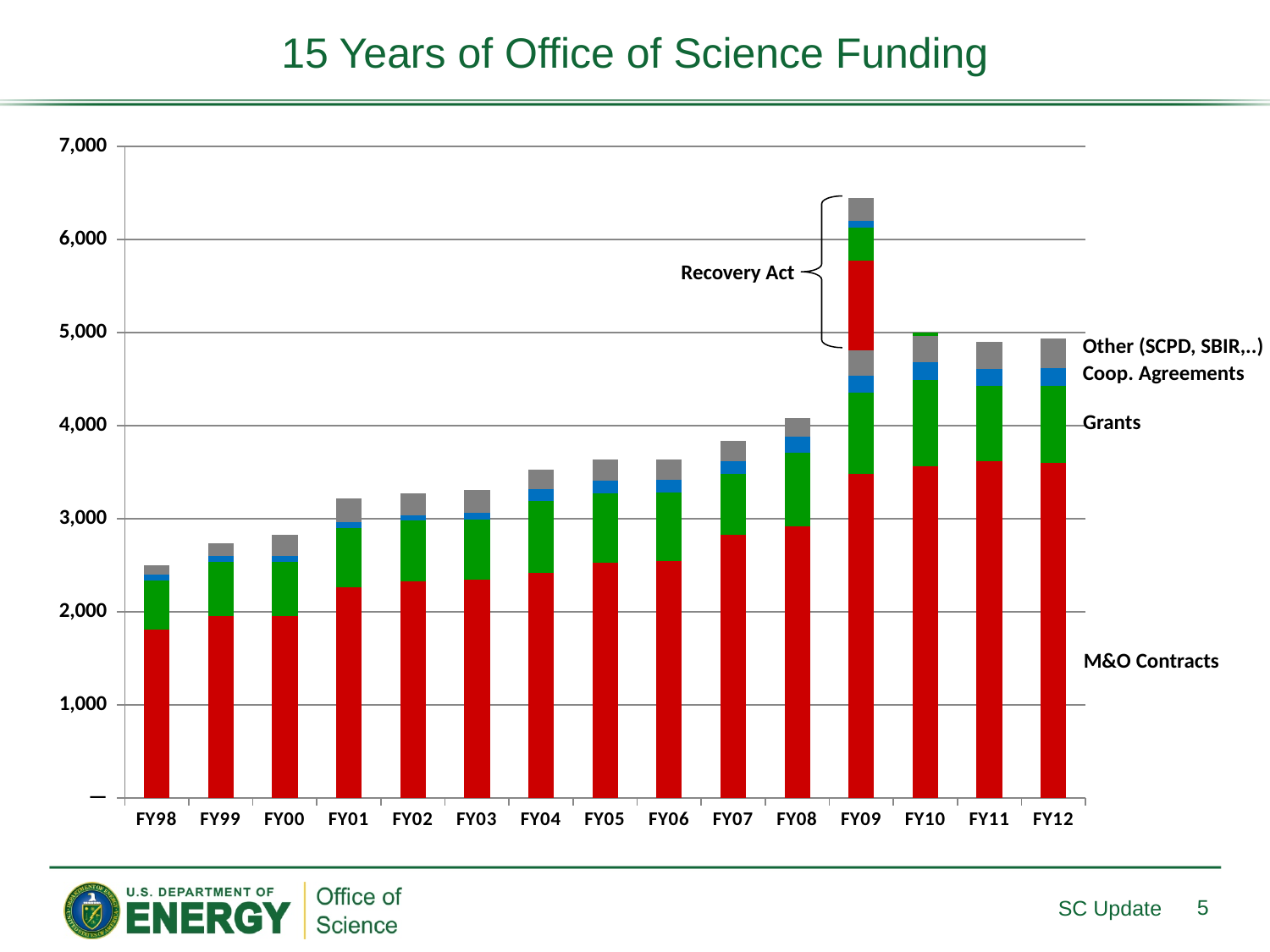
How many funding categories are labelled on the right side of the chart? 4 Is the total bar for FY07 greater or less than 4,000? less What annotation labels the extra portion of the FY09 bar? Recovery Act What kind of chart is shown on the slide? Stacked bar chart Is the M&O Contracts segment for FY98 greater or less than 2,000? less Which has the larger total bar, FY09 or FY10? FY09 Is the total bar for FY09 greater or less than 6,000? greater How many fiscal years are shown on the x axis of the chart? 15 Which fiscal year has the tallest total bar? FY09 Which fiscal year has the shortest total bar? FY98 Do the total bars generally rise or fall from FY98 to FY12? rise